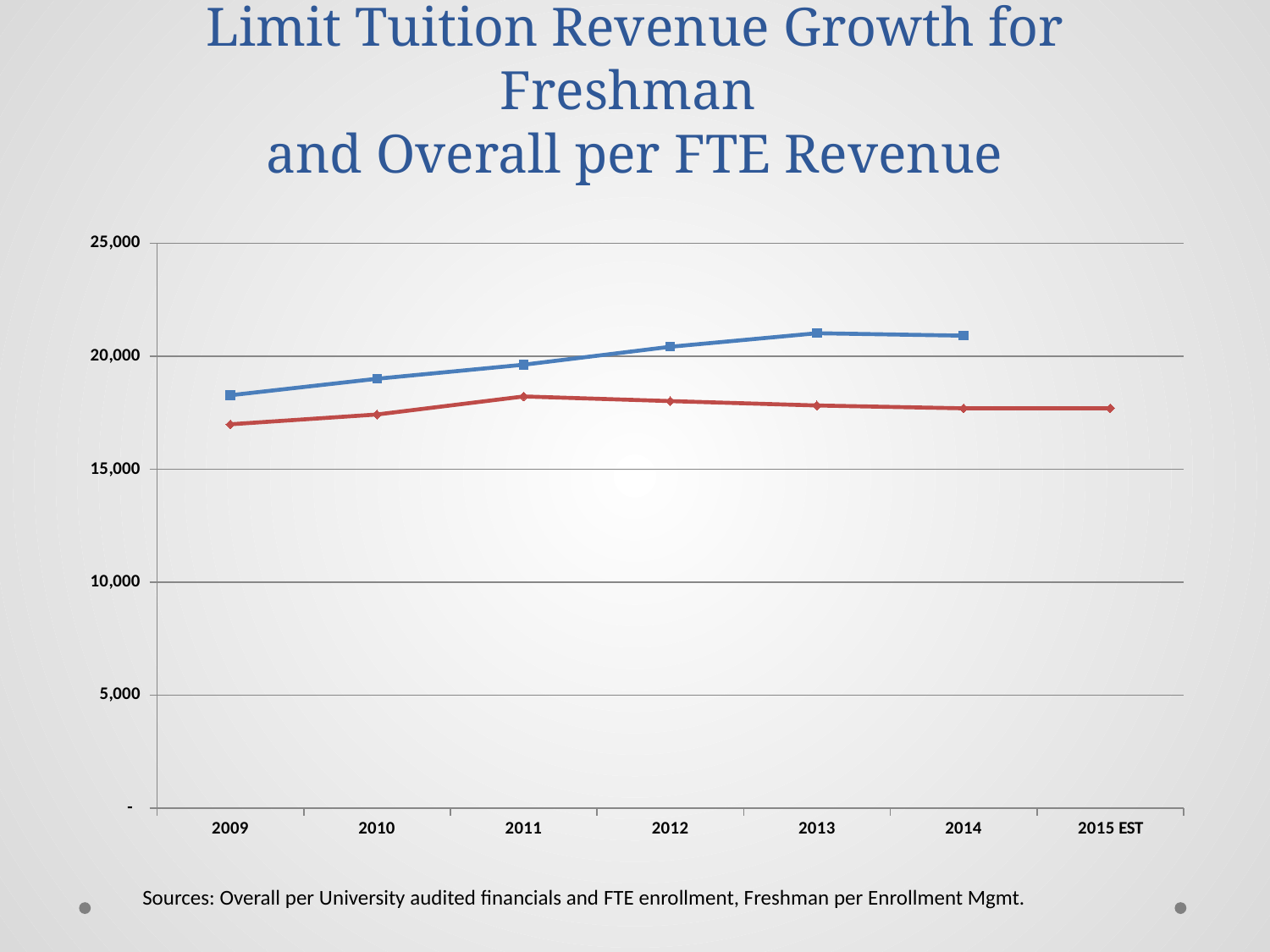
What is the last category label on the x axis? 2015 EST Does the blue line generally rise or fall from 2009 to 2013? rise In 2013, which line has the larger value, the blue line or the red line? the blue line Is the value of the blue line for 2013 greater or less than 20,000? greater What kind of chart is shown on the slide? line chart Is the value of the red line for 2011 greater or less than 20,000? less Is the value of the blue line for 2009 greater or less than 20,000? less In which year is the blue line at its lowest? 2009 How many categories are shown on the x axis? 7 How many data points does the blue line have? 6 In which year is the red line at its highest? 2011